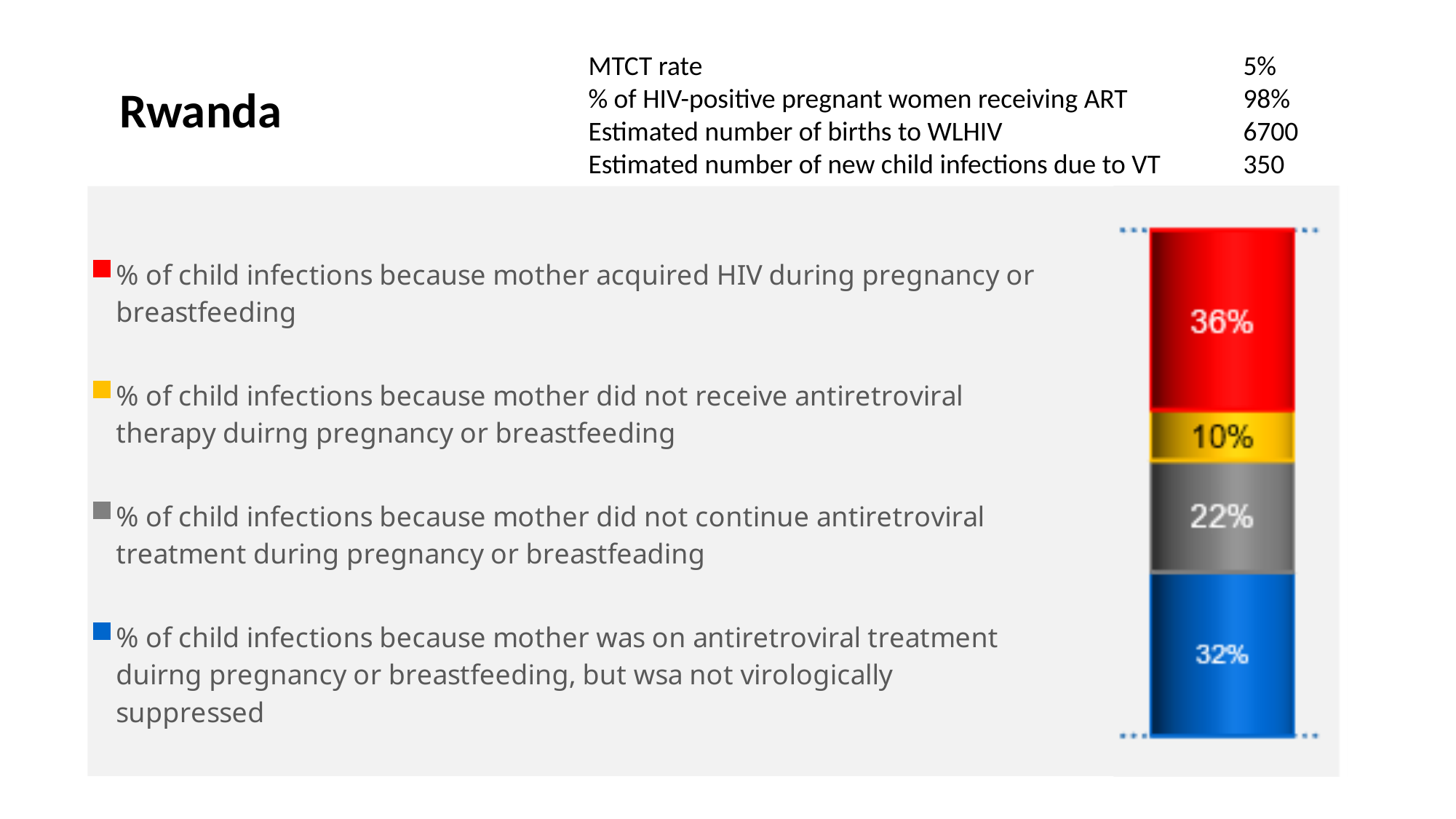
What is the total of all segments in the stacked bar? 100% What percentage of child infections is attributed to the mother not continuing antiretroviral treatment during pregnancy or breastfeeding? 22% Which cause accounts for the smallest share of child infections in the stacked bar? Mother did not receive antiretroviral therapy during pregnancy or breastfeeding What percentage of child infections is attributed to the mother acquiring HIV during pregnancy or breastfeeding? 36% What percentage of child infections is attributed to the mother not receiving antiretroviral therapy during pregnancy or breastfeeding? 10% Which cause accounts for the largest share of child infections in the stacked bar? Mother acquired HIV during pregnancy or breastfeeding How many segments make up the stacked bar? 4 What is the difference between the share for mother acquired HIV during pregnancy or breastfeeding and the share for mother not virologically suppressed? 4% What colour is the segment representing child infections because the mother did not receive antiretroviral therapy? Yellow Which is larger: the share for mother did not continue antiretroviral treatment or the share for mother did not receive antiretroviral therapy? Mother did not continue antiretroviral treatment What is the difference between the share for mother did not continue antiretroviral treatment and the share for mother did not receive antiretroviral therapy? 12% What percentage of child infections is attributed to the mother being on antiretroviral treatment but not virologically suppressed? 32%